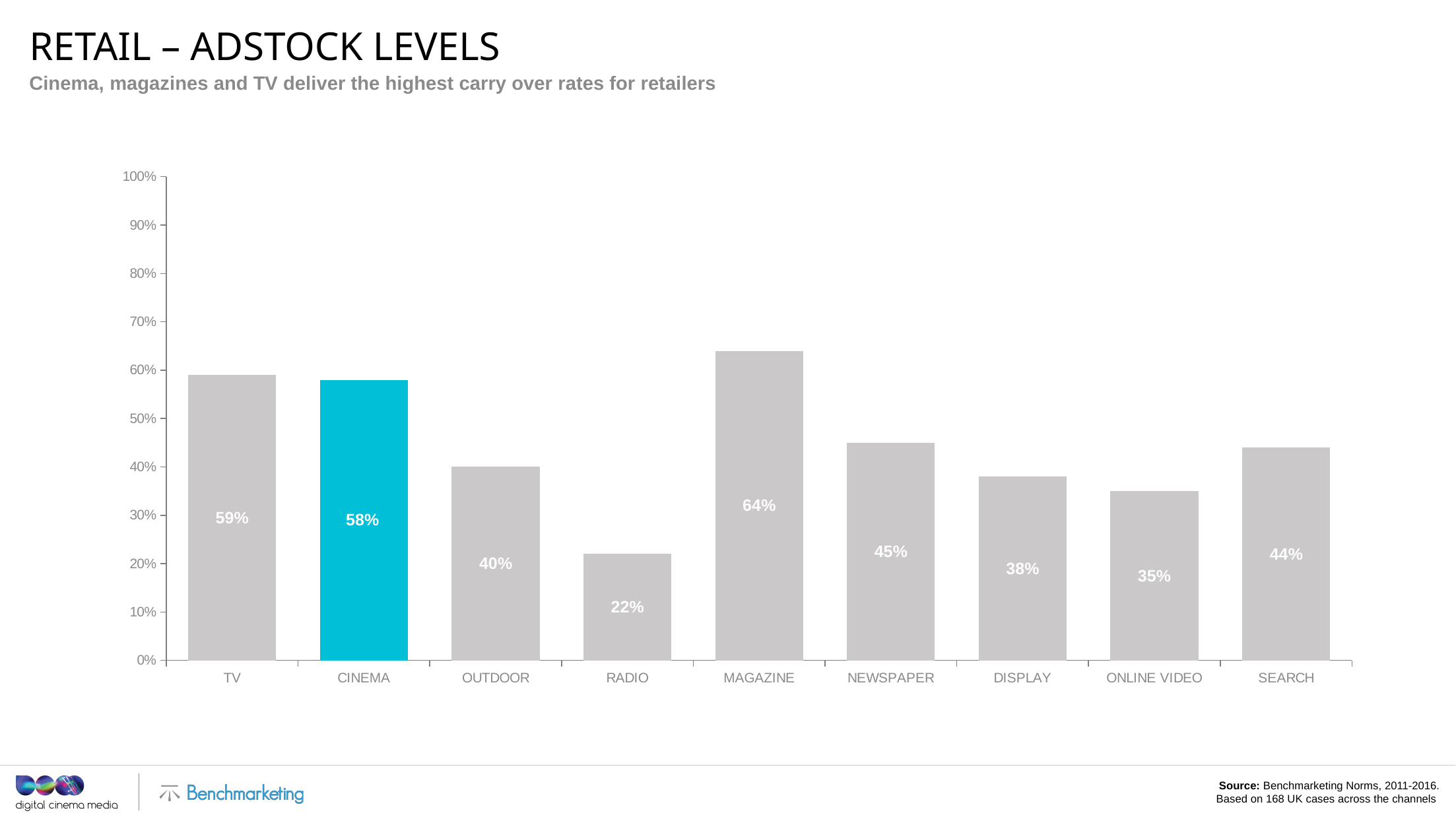
Which has a higher adstock level, NEWSPAPER or SEARCH? NEWSPAPER What is the difference between the adstock levels for TV and RADIO? 37% Which channel has the lowest adstock level? RADIO What is the adstock level for MAGAZINE? 64% Which bar is highlighted in a different colour (blue) from the others? CINEMA Is the value for DISPLAY greater or less than 40%? less Which channel has the highest adstock level? MAGAZINE What kind of chart is shown on the slide? bar chart What is the adstock level for CINEMA? 58% What is the difference between the adstock levels for MAGAZINE and CINEMA? 6% How many channels are shown on the chart? 9 What is the adstock level for ONLINE VIDEO? 35%